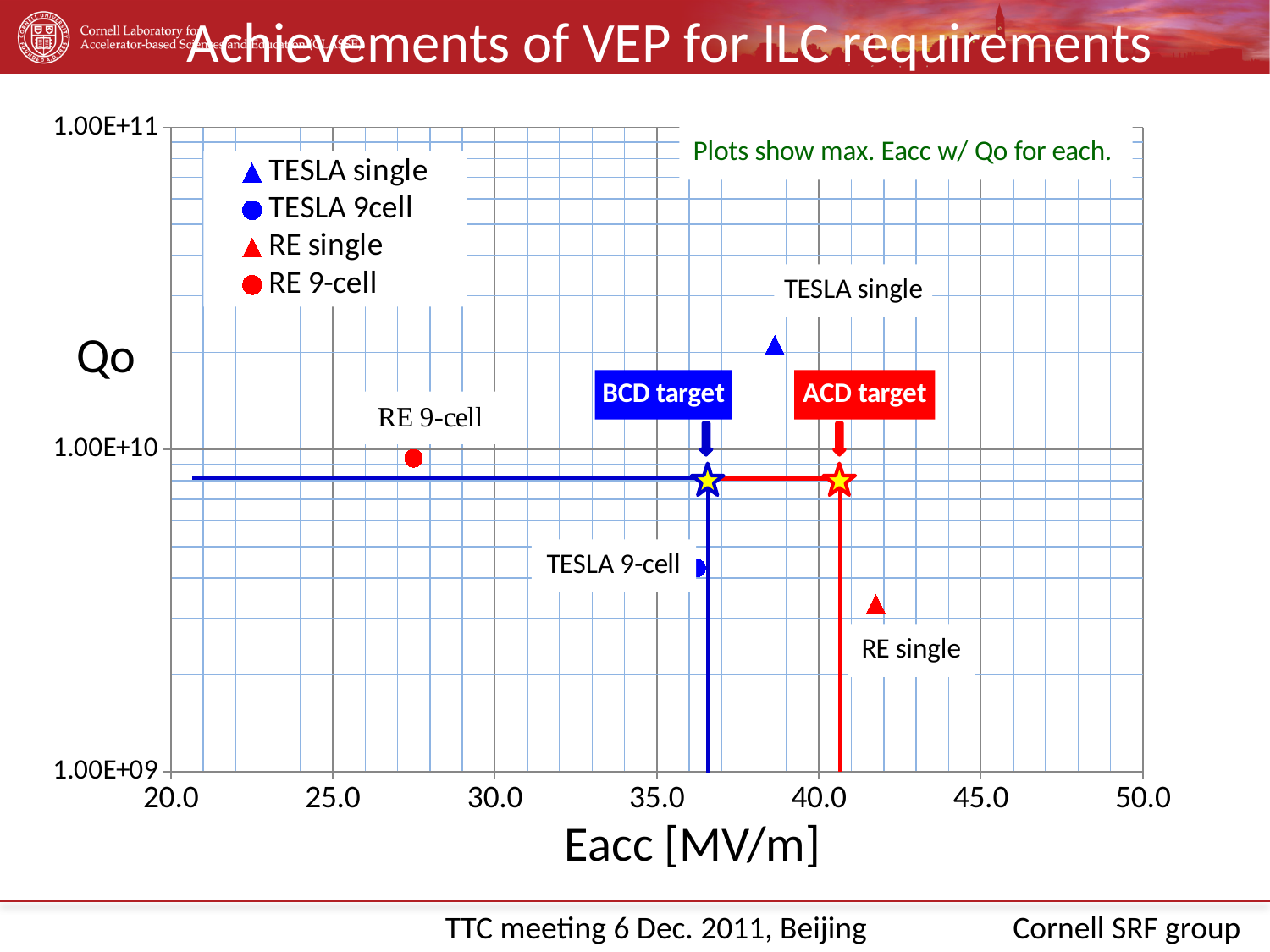
Which series has the highest Eacc value? RE single What kind of chart is shown on the slide? Scatter plot Is the Eacc value for RE 9-cell greater or less than 30.0 MV/m? less How many series does the legend list? 4 Is the Qo value for TESLA single greater or less than 1.00E+10? greater Which series has the lowest Qo value? RE single Which has a higher Qo value, TESLA single or RE single? TESLA single What is the label of the x axis? Eacc [MV/m] Which series has the lowest Eacc value? RE 9-cell Is the Eacc value for RE single greater or less than 40.0 MV/m? greater Which series has the highest Qo value? TESLA single How many data points are plotted on the chart? 4